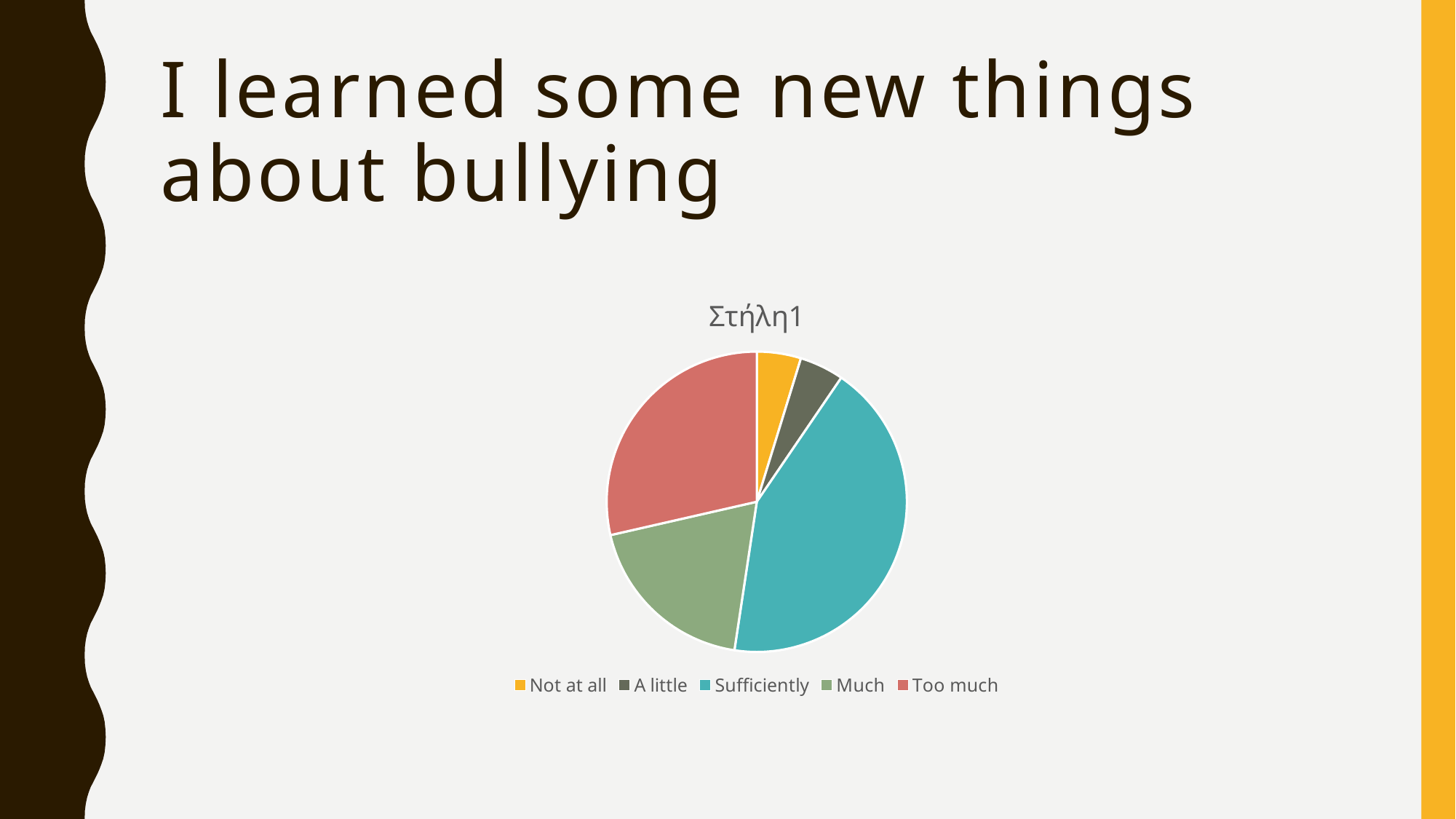
Which slice is larger, Much or A little? Much Which category has the largest slice of the pie chart? Sufficiently What colour is the Sufficiently slice in the pie chart? Teal What is the title shown above the pie chart? Στήλη1 Which slice is larger, Sufficiently or Too much? Sufficiently Which slice is larger, Sufficiently or Much? Sufficiently What kind of chart is shown on the slide? Pie chart How many categories does the pie chart show? 5